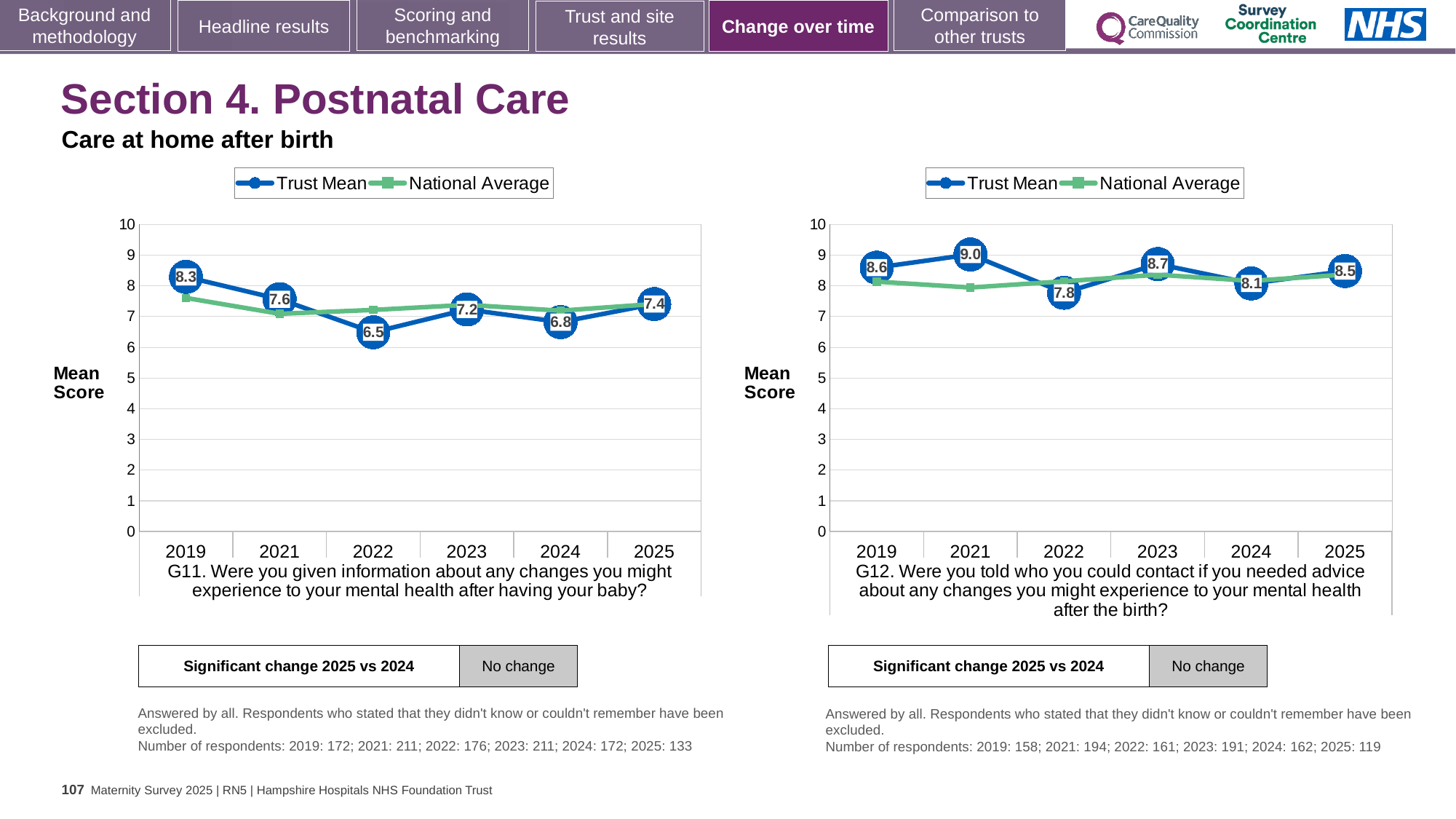
On the G12 chart (right), is the Trust Mean for 2023 or for 2024 larger? 2023 On the G12 chart (right), what is the Trust Mean for 2021? 9.0 On the G12 chart (right), is the National Average for 2021 greater or less than 9? less How many years are plotted on the x axis of the G11 chart (left)? 6 How many series does the legend of the G12 chart (right) list? 2 On the G12 chart (right), which year has the lowest Trust Mean? 2022 On the G11 chart (left), what is the Trust Mean for 2022? 6.5 On the G11 chart (left), what is the Trust Mean for 2019? 8.3 On the G12 chart (right), what is the Trust Mean for 2025? 8.5 On the G11 chart (left), which year has the highest Trust Mean? 2019 On the G11 chart (left), what is the difference between the Trust Mean in 2019 and in 2022? 1.8 On the G11 chart (left), which year has the lowest Trust Mean? 2022